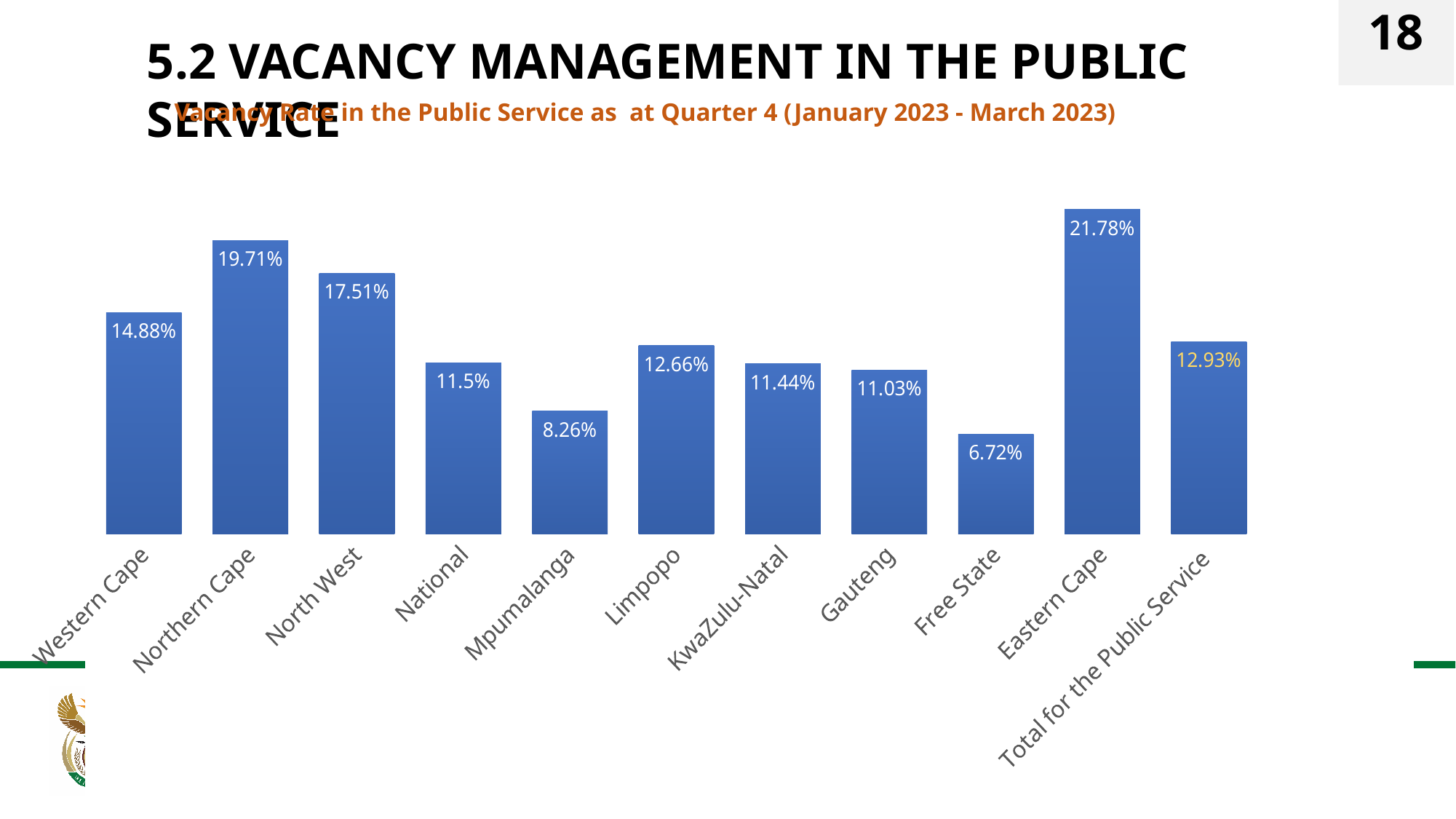
Which has a higher vacancy rate, Limpopo or Gauteng? Limpopo Which category has the highest vacancy rate? Eastern Cape How many categories are shown in the chart? 11 Which has a higher vacancy rate, Western Cape or Mpumalanga? Western Cape What is the vacancy rate for KwaZulu-Natal? 11.44% Which category has the lowest vacancy rate? Free State What is the vacancy rate for Free State? 6.72% What is the vacancy rate for Northern Cape? 19.71% What is the vacancy rate for the Total for the Public Service? 12.93% What type of chart is shown on the slide? Bar chart What is the difference between the vacancy rates of North West and National? 6.01% What is the difference between the vacancy rates of Eastern Cape and Free State? 15.06%